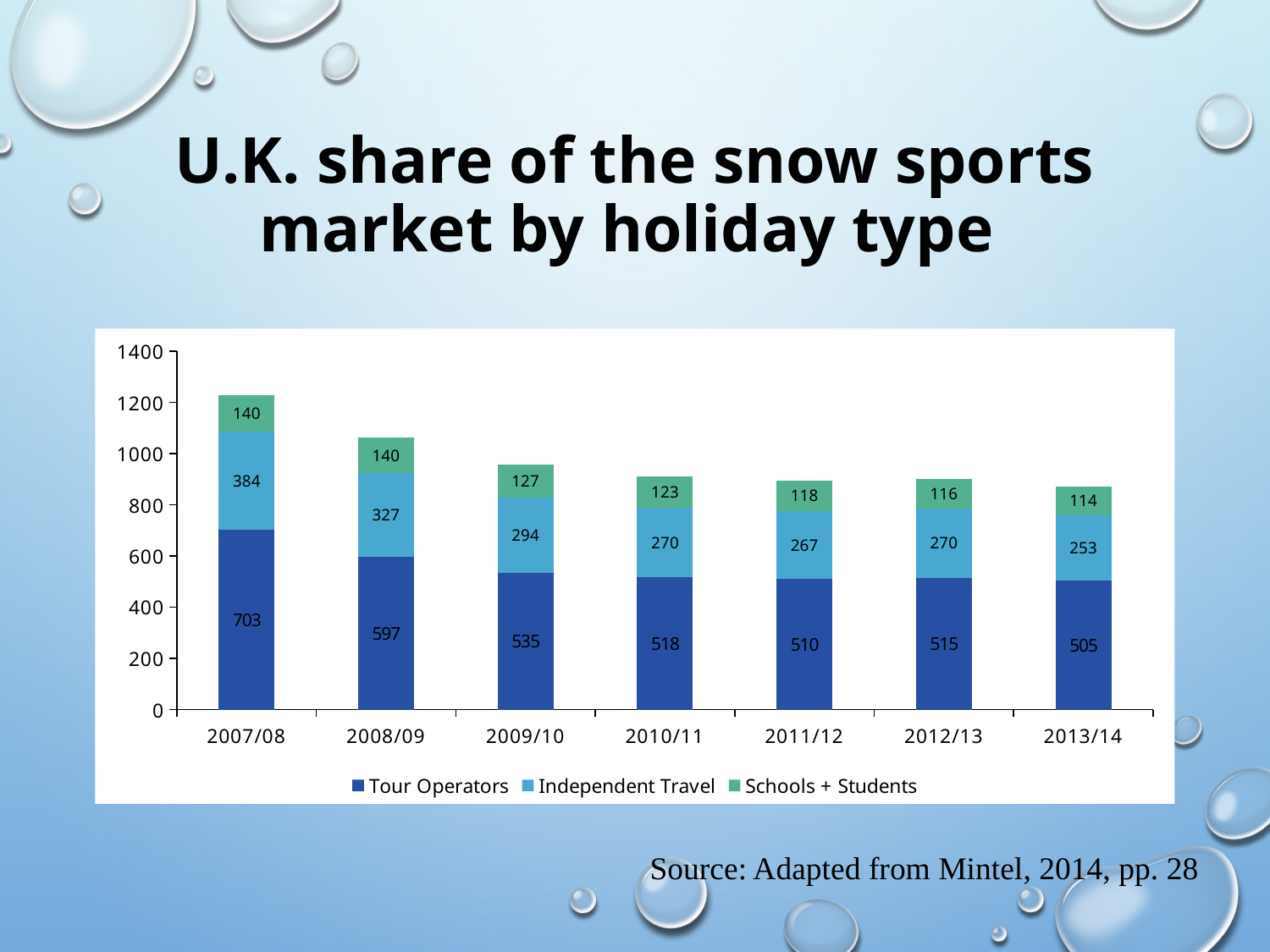
What is the total of the stacked bar for 2007/08? 1227 What is the Schools + Students value for 2013/14? 114 How many years are shown on the x axis? 7 What is the total of the stacked bar for 2013/14? 872 What is the Tour Operators value for 2007/08? 703 How many series does the legend list? 3 Which year has the highest Tour Operators value? 2007/08 What is the difference between the Tour Operators values for 2007/08 and 2008/09? 106 What kind of chart is shown? Stacked bar chart What is the Independent Travel value for 2011/12? 267 Which year has the lowest Independent Travel value? 2013/14 Which is larger, the Independent Travel value for 2009/10 or for 2012/13? 2009/10